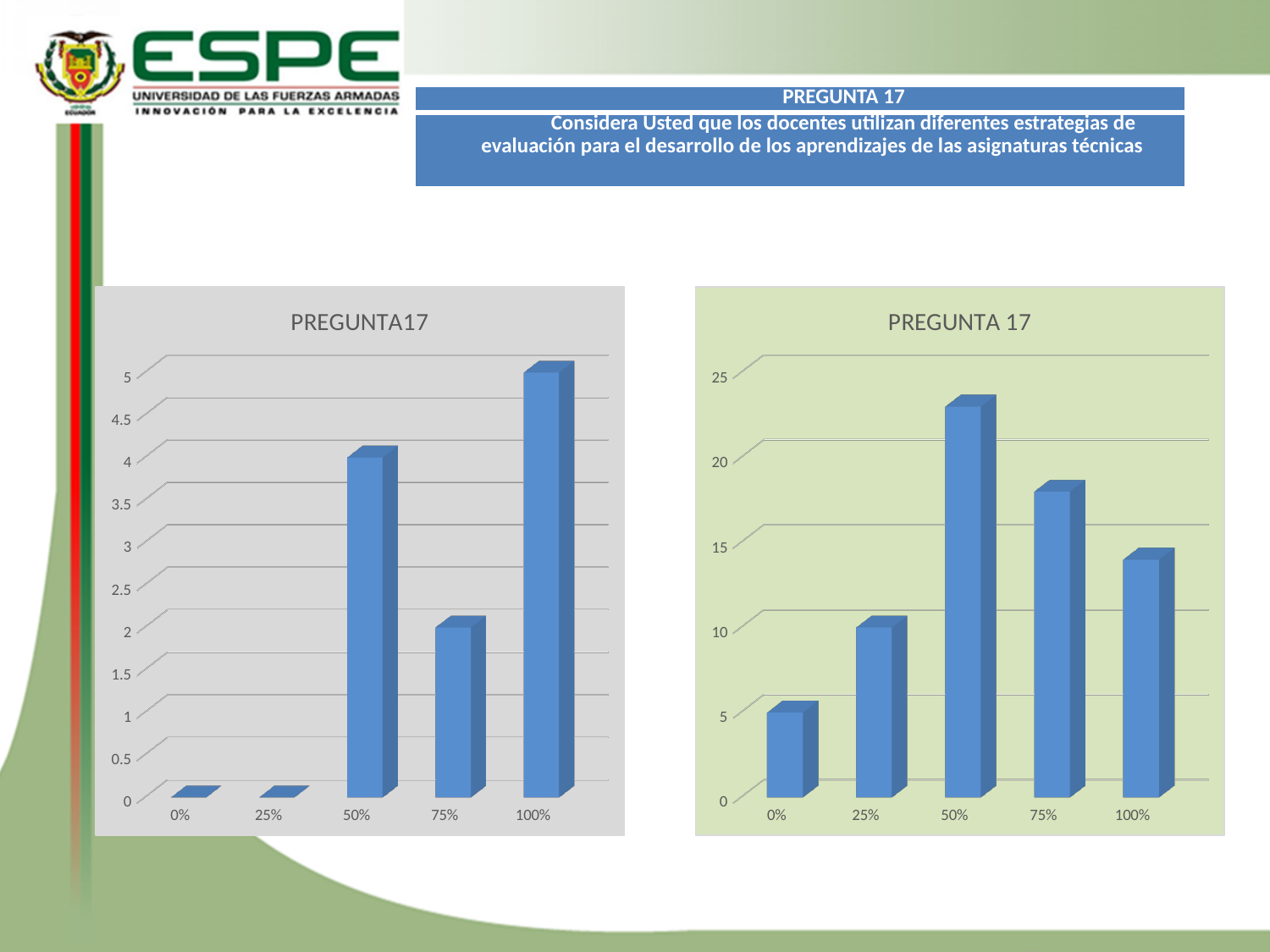
On the left chart (grey background), which category has the highest value? 100% On the right chart (green background), what is the value for 0%? 5 On the right chart (green background), is the value for 100% greater or less than 15? less On the left chart (grey background), what is the value for 50%? 4 On the left chart (grey background), what is the difference between the values for 50% and 75%? 2 What type of chart is the right chart (green background)? Bar chart On the right chart (green background), is the value for 50% greater or less than 20? greater On the left chart (grey background), what is the value for 100%? 5 On the right chart (green background), which category has the highest value? 50% On the right chart (green background), which is larger, the value for 75% or the value for 100%? 75% On the right chart (green background), what is the value for 25%? 10 On the left chart (grey background), how many categories are shown on the x axis? 5